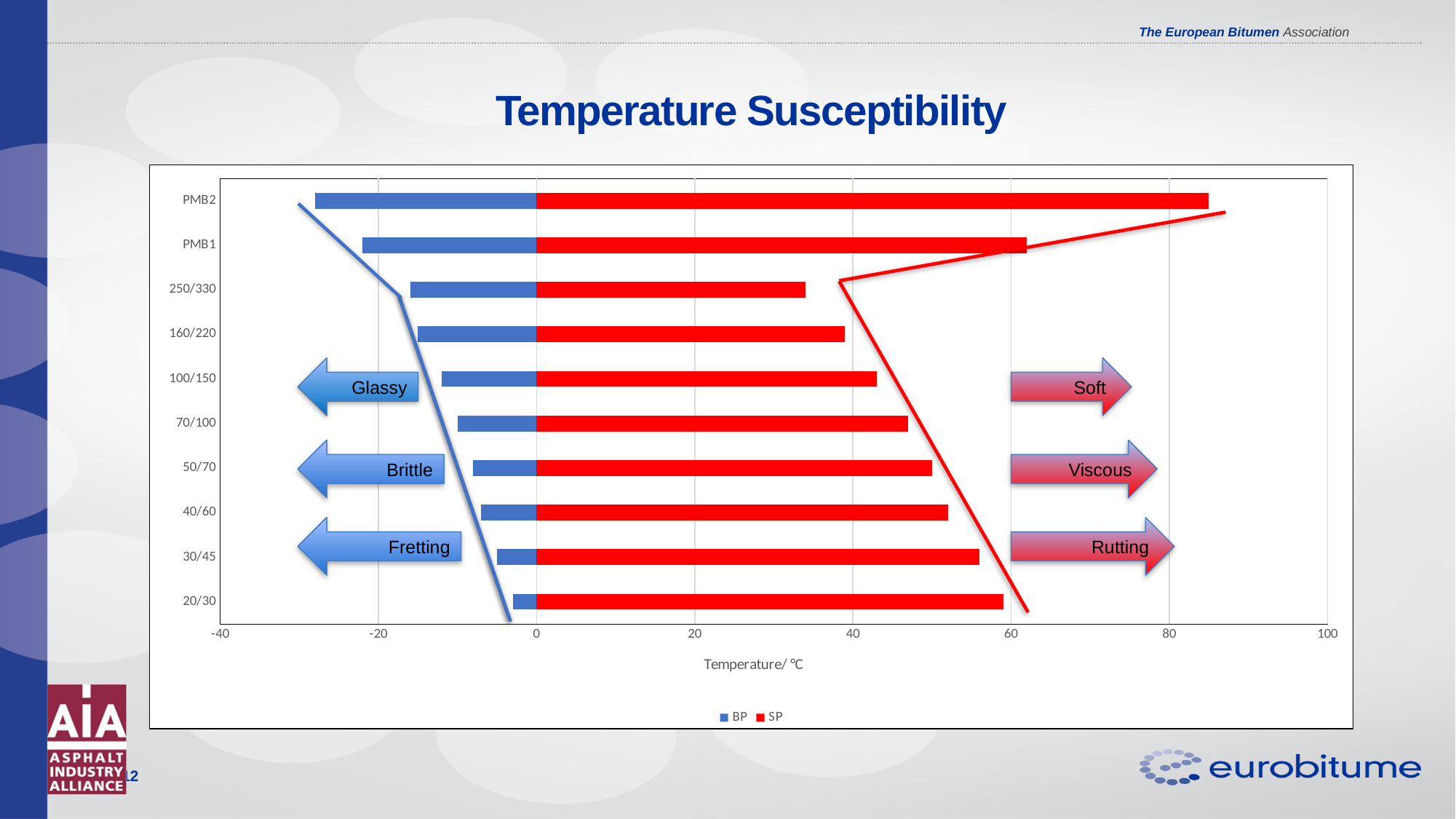
Is the SP value for 250/330 greater or less than 40? less How many categories are listed on the vertical axis of the chart? 10 Going from 20/30 up through the grades to 250/330, do the SP values rise or fall? fall What is the title of the horizontal axis of the chart? Temperature/ °C Which has the larger SP value, 20/30 or 100/150? 20/30 Which category has the lowest (most negative) BP value? PMB2 What kind of chart is shown on the slide? bar chart Which category has the highest SP value? PMB2 Is the SP value for PMB2 greater or less than 80? greater How many series does the chart legend list? 2 Which category has the lowest SP value? 250/330 Is the BP value for PMB2 greater or less than -20? less